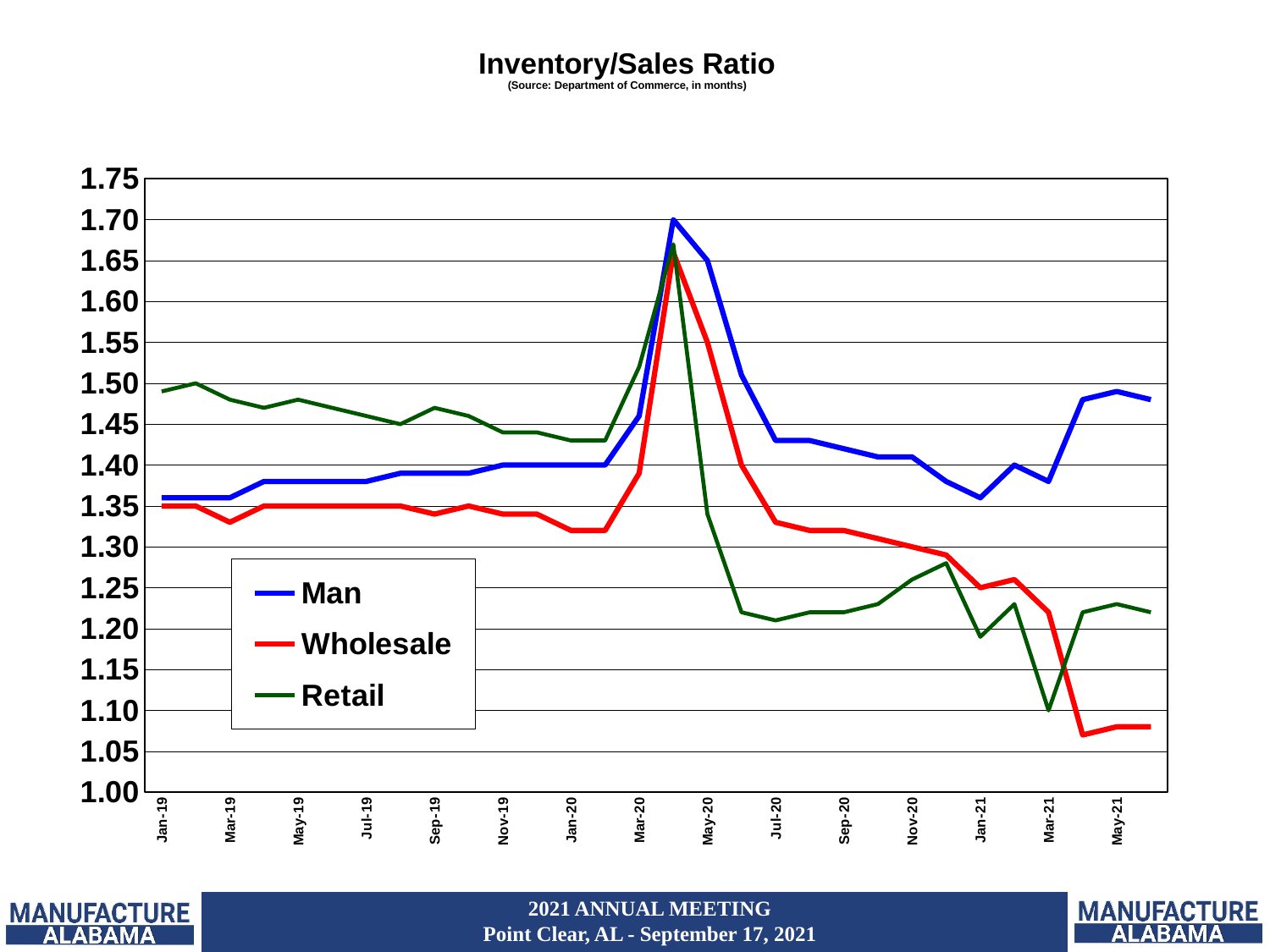
How many series does the legend list? 3 What is the title of the chart? Inventory/Sales Ratio Is the value for Retail at Mar-21 greater or less than 1.15? less Is the value for Wholesale at May-21 greater or less than 1.10? less What are the three series named in the legend? Man, Wholesale, Retail Does the Wholesale line rise or fall from Jan-21 to Apr-21? fall Is the value for Man at its peak around Apr-20 greater or less than 1.65? greater What kind of chart is shown on the slide? line chart At May-21, which is larger, the Man value or the Wholesale value? Man Which series has the lowest value at May-21? Wholesale At Jan-19, which is larger, the Retail value or the Man value? Retail